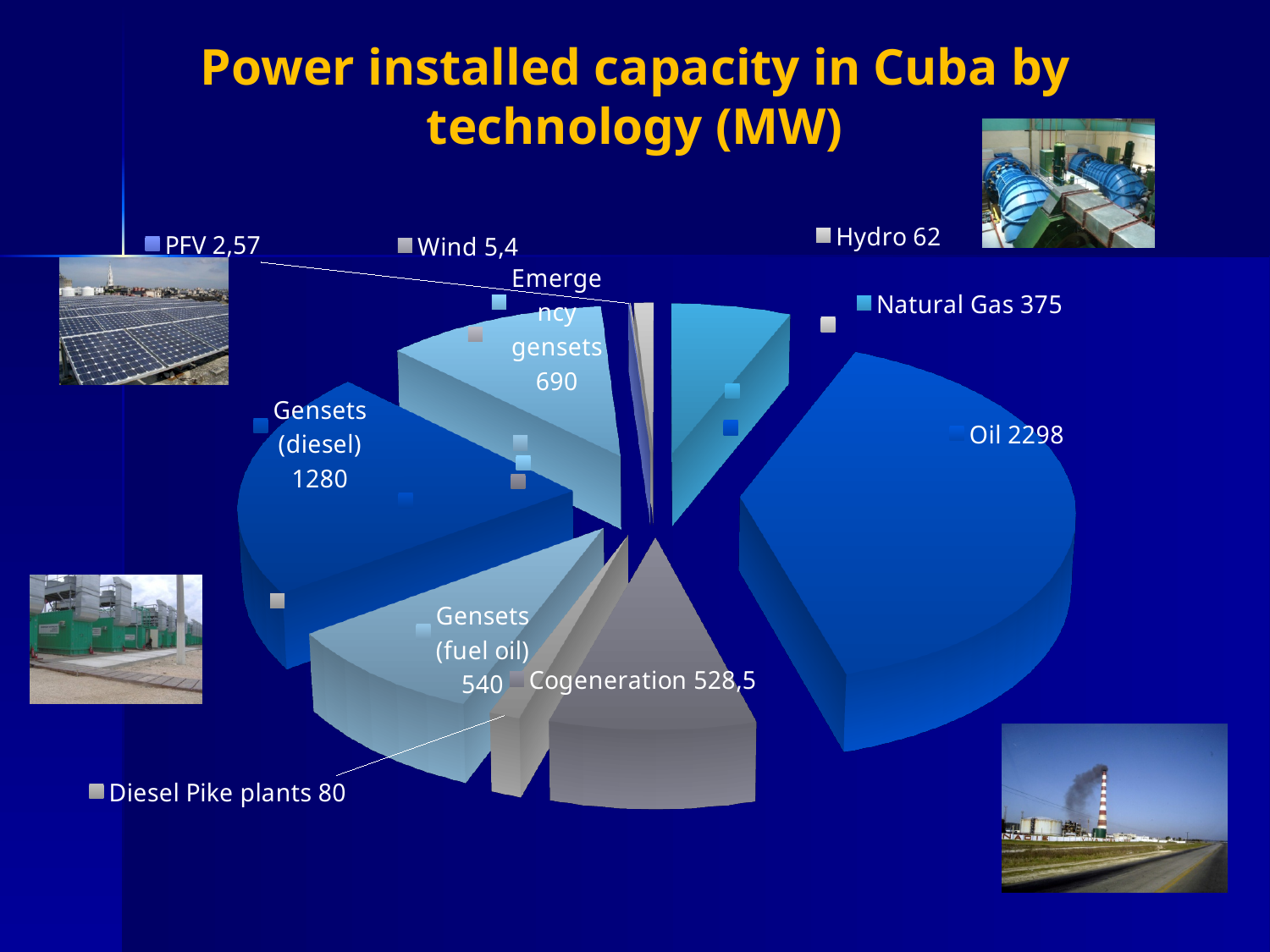
What is the installed capacity for Natural Gas? 375 Which technology has the smallest installed capacity? PFV Which has a larger installed capacity, Emergency gensets or Gensets (fuel oil)? Emergency gensets What type of chart is shown on the slide? pie chart What is the difference between the installed capacity of Oil and Gensets (diesel)? 1018 What is the installed capacity for Hydro? 62 What is the installed capacity for Oil? 2298 Which technology has the largest installed capacity? Oil What is the installed capacity for Cogeneration? 528,5 What is the title of the chart? Power installed capacity in Cuba by technology (MW) What is the difference between the installed capacity of Natural Gas and Hydro? 313 How many technology categories are shown in the pie chart? 10